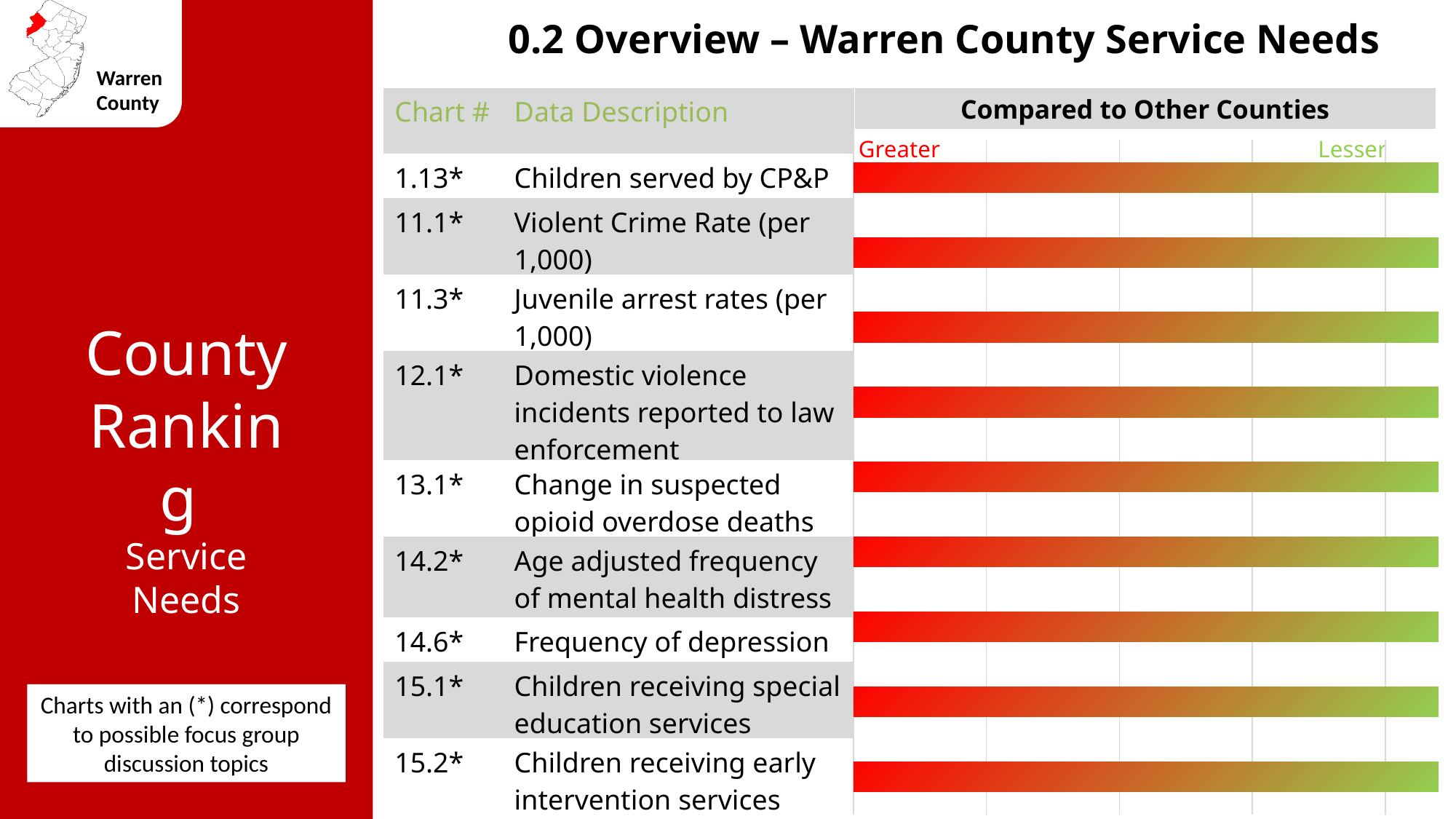
What kind of chart is used to show the comparison to other counties? bar chart How many data description rows have a bar in the 'Compared to Other Counties' chart? 9 What is the title of the chart column on the right of the slide? Compared to Other Counties What chart number is listed for 'Children served by CP&P'? 1.13* What chart number is listed for 'Frequency of depression'? 14.6* What label appears at the left end of the chart's scale? Greater